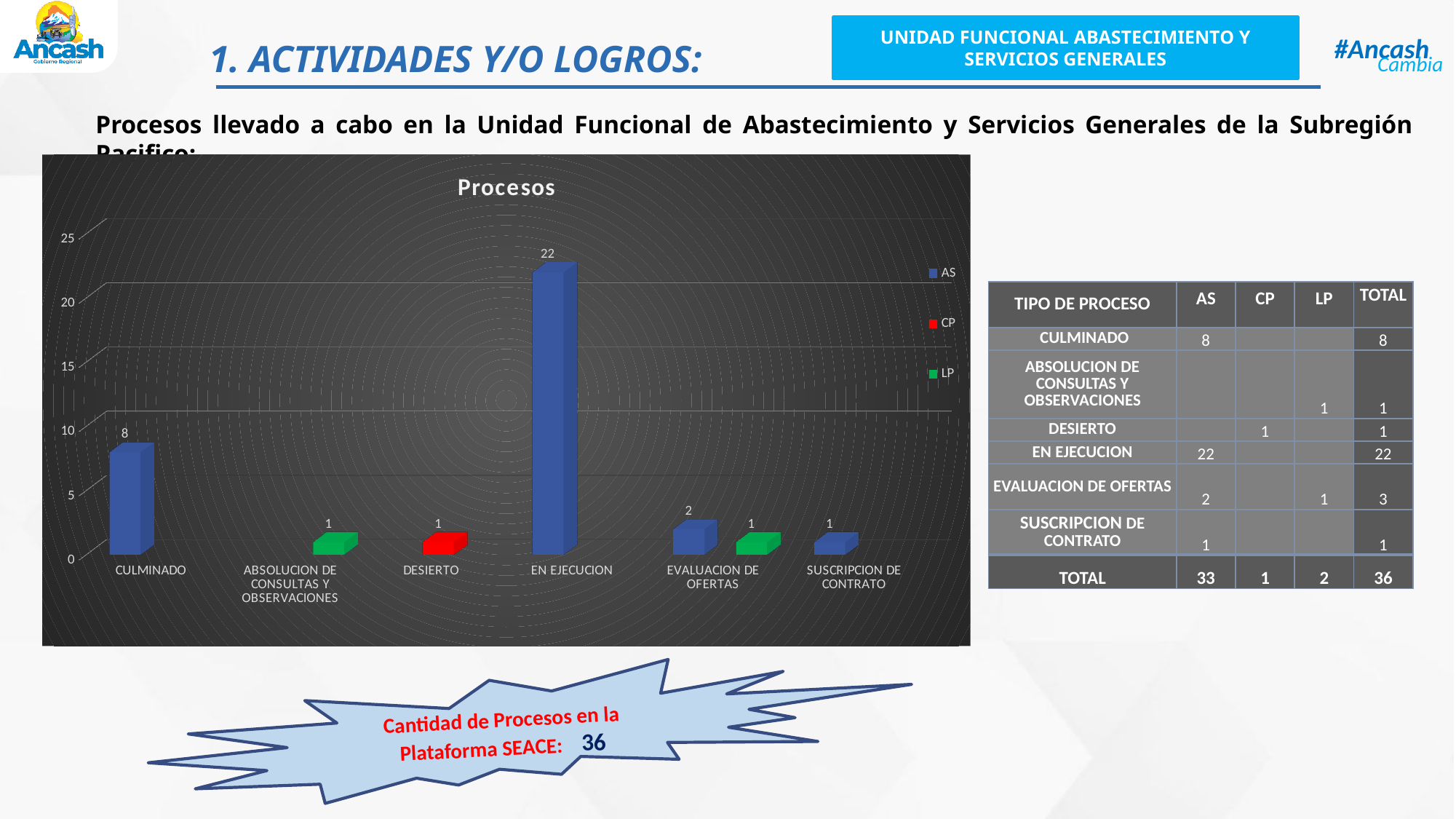
How many categories are shown on the x axis of the chart? 6 Which is larger, the AS value for CULMINADO or the AS value for EVALUACION DE OFERTAS? CULMINADO What is the CP value for DESIERTO? 1 What is the AS value for CULMINADO? 8 Which category has the highest AS value? EN EJECUCION What is the difference between the AS values for EN EJECUCION and CULMINADO? 14 What is the title of the chart? Procesos What kind of chart is shown on the slide? bar chart What is the LP value for EVALUACION DE OFERTAS? 1 Which colour represents the CP series in the chart? red How many series does the chart legend list? 3 What is the AS value for EN EJECUCION? 22